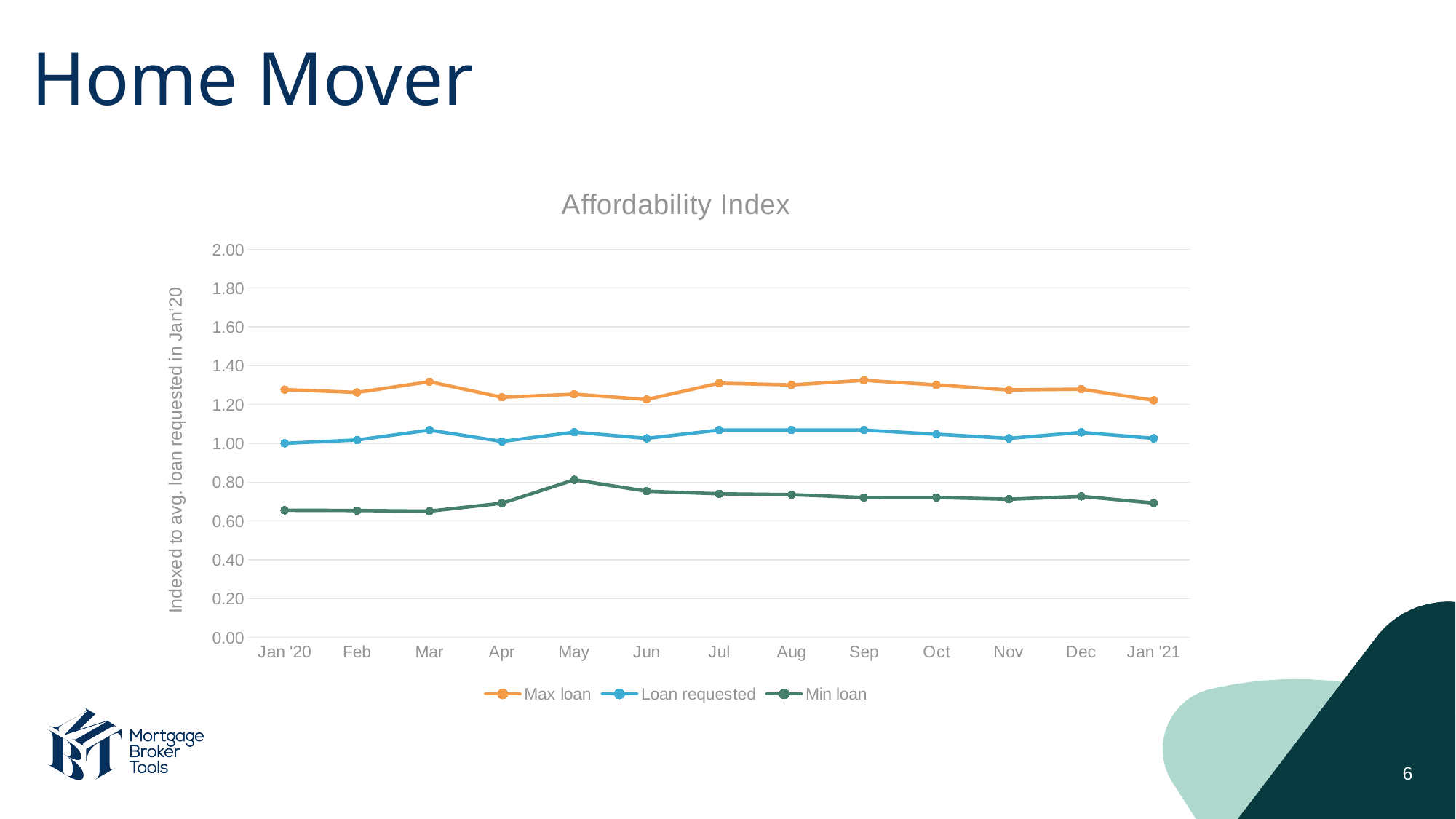
How many months are plotted along the x axis? 13 What type of chart is shown on the slide? line chart How many series does the legend list? 3 In which month does the Min loan series reach its highest value? May Which series has the larger value in Dec, Max loan or Min loan? Max loan Does the Min loan series rise or fall from Apr to May? rise Is the value for Max loan in Sep greater or less than 1.20? greater Is the value for Loan requested in Jul greater or less than 1.00? greater Which is larger for Min loan, the value in May or the value in Jan '20? May Is the value for Min loan in Jan '20 greater or less than 0.80? less What is the label on the vertical axis? Indexed to avg. loan requested in Jan'20 What is the title of the chart? Affordability Index